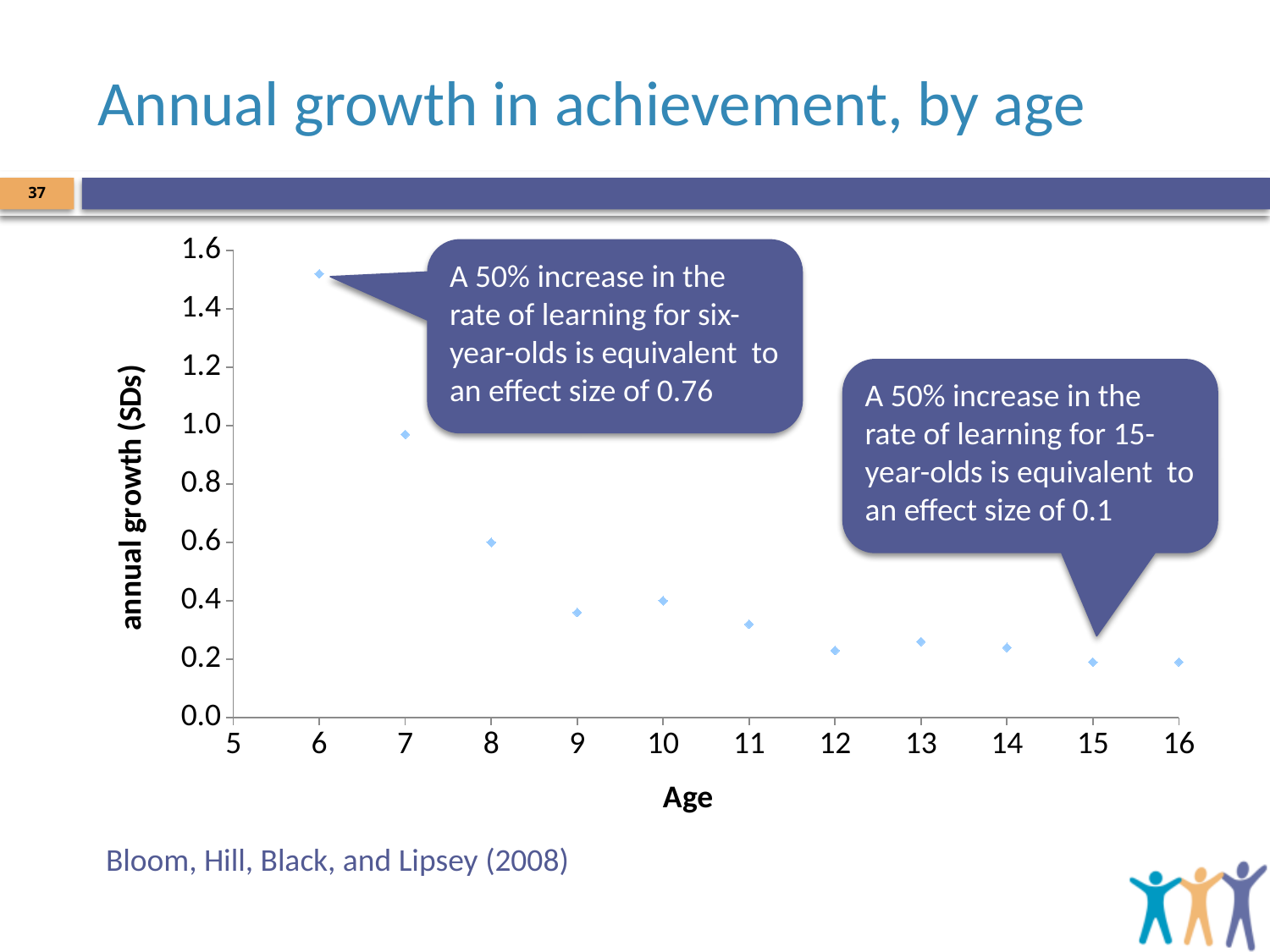
Is the value for age 9 greater or less than 0.6? less How many data points are plotted in the chart? 11 What kind of chart is shown on the slide? scatter chart At which age is annual growth highest? 6 Is the value for age 15 greater or less than 0.4? less Which has a higher annual growth value, age 6 or age 7? age 6 Do the values generally rise or fall as age increases? fall Is the value for age 8 greater or less than 0.8? less Which has a higher annual growth value, age 8 or age 12? age 8 What is the label on the vertical axis of the chart? annual growth (SDs)